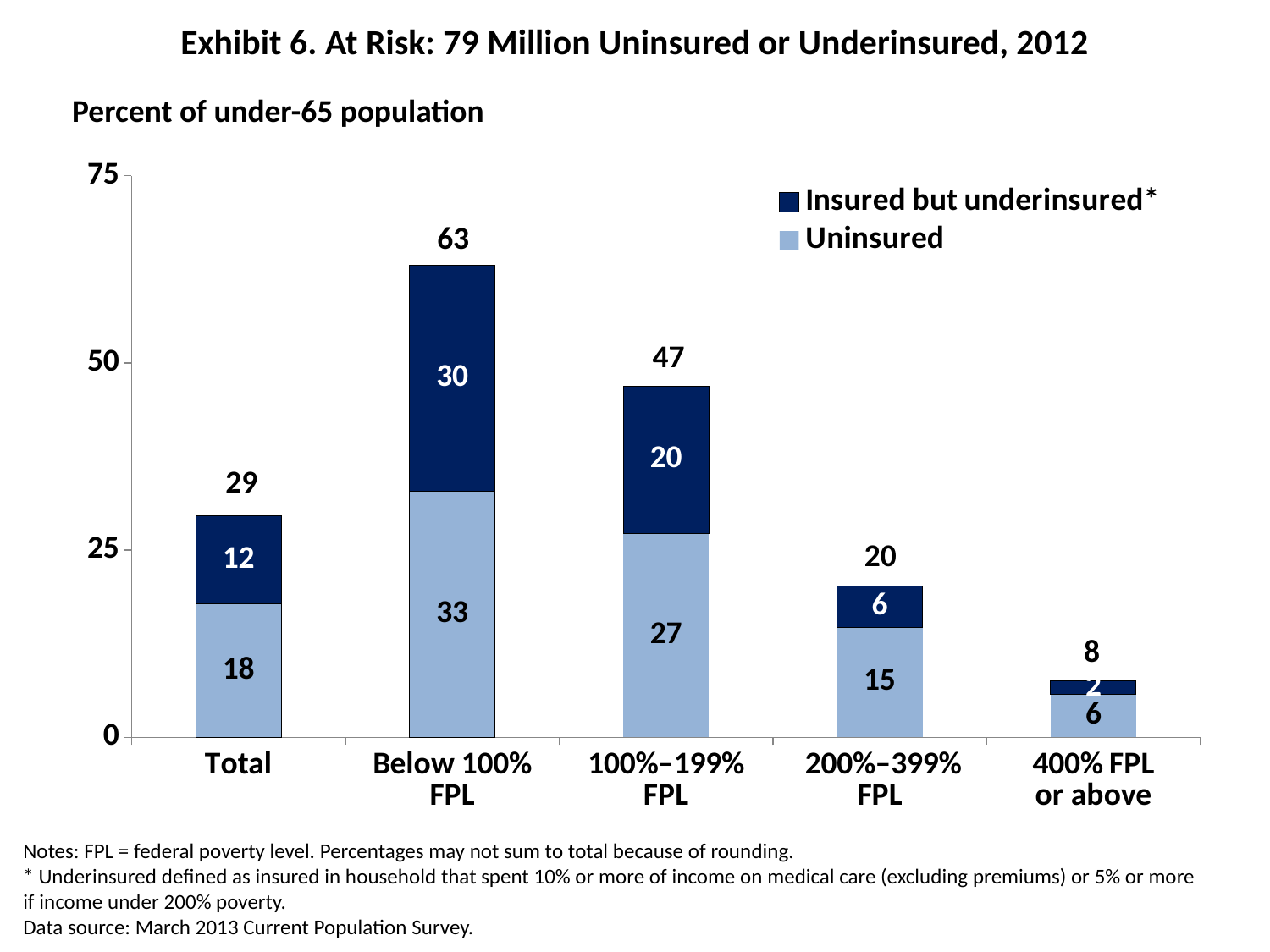
What is the difference between the Uninsured values for Below 100% FPL and 200%–399% FPL? 18 How many categories are shown on the x axis? 5 Is the stacked total for 100%–199% FPL greater or less than 50? less How many series does the legend list? 2 What is the Uninsured value for the Total category? 18 Which is larger: the Insured but underinsured value for Total or for 200%–399% FPL? Total Which category has the highest stacked total? Below 100% FPL What is the Uninsured value for the Below 100% FPL category? 33 What kind of chart is shown on the slide? Stacked bar chart What is the Insured but underinsured value for the 100%–199% FPL category? 20 Which category has the lowest Uninsured value? 400% FPL or above What is the total labeled above the stacked bar for 200%–399% FPL? 20